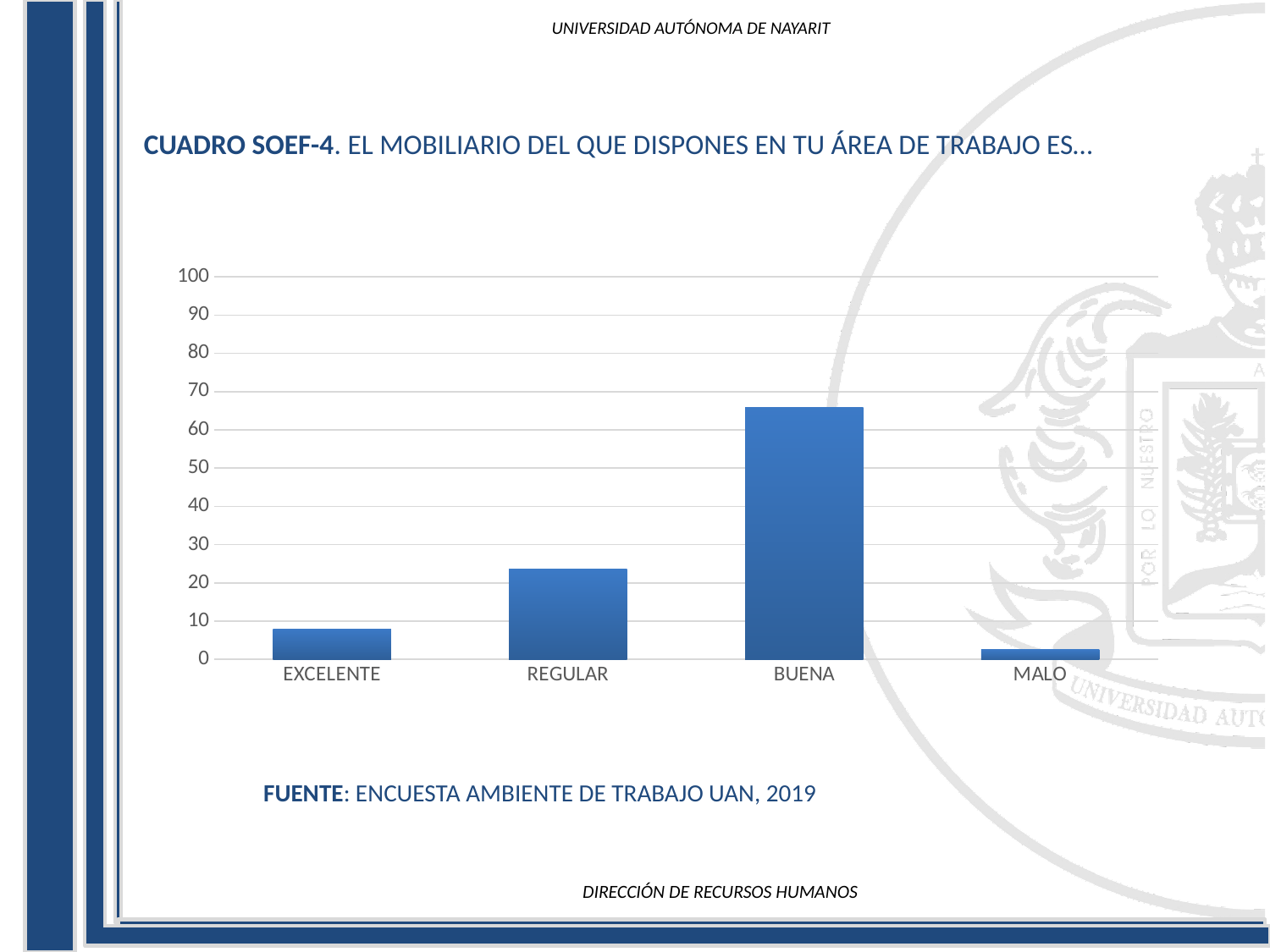
Which is larger, the value for REGULAR or the value for EXCELENTE? REGULAR How many categories are shown on the x axis of the chart? 4 Is the value for REGULAR greater or less than 20? greater Which category has the highest bar in the chart? BUENA Is the value for EXCELENTE greater or less than 10? less Is the value for BUENA greater or less than 60? greater Which category has the lowest bar in the chart? MALO What kind of chart is shown on the slide? bar chart What is the source cited below the chart? ENCUESTA AMBIENTE DE TRABAJO UAN, 2019 Which is larger, the value for EXCELENTE or the value for MALO? EXCELENTE